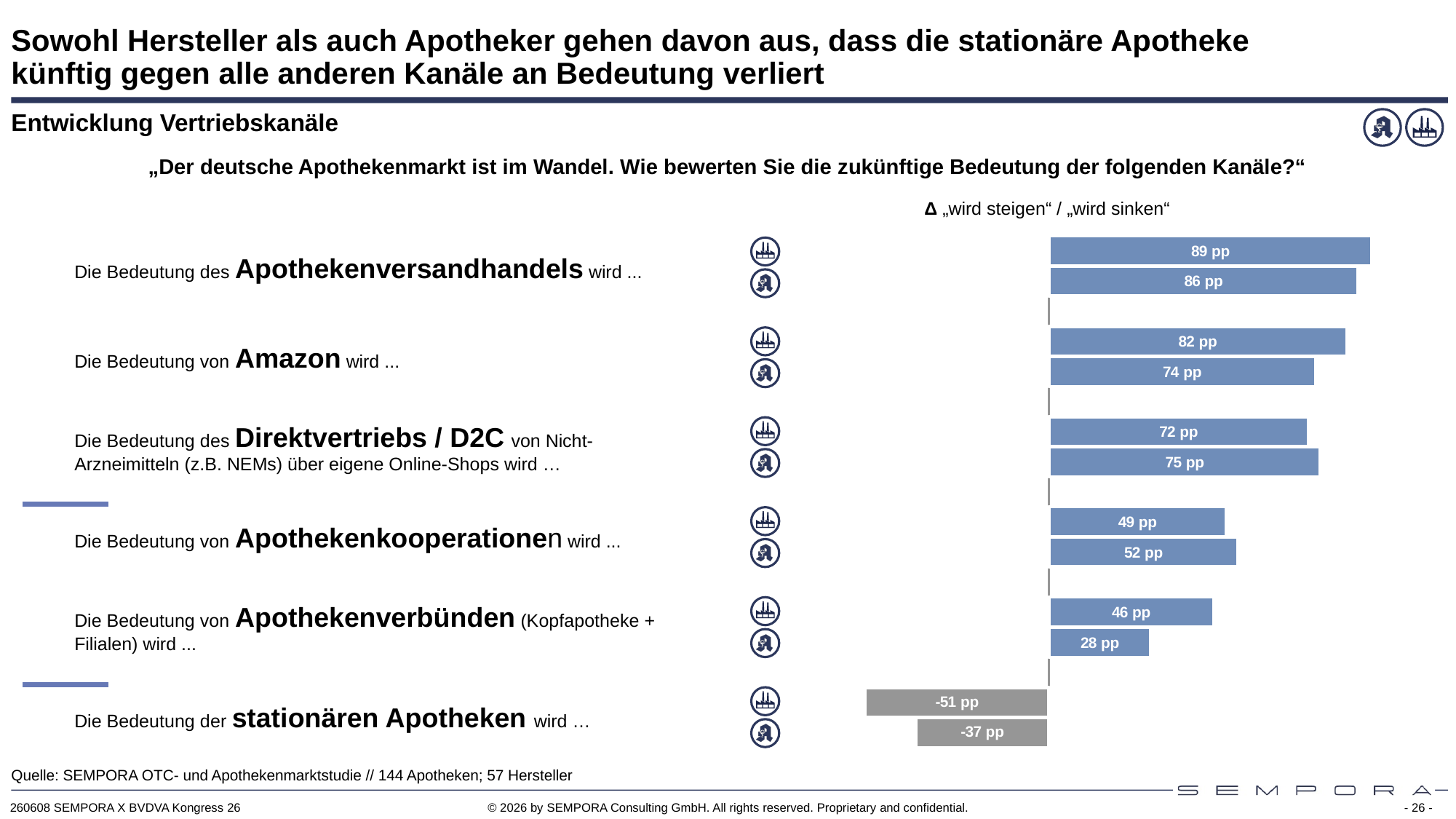
Which channel has the lowest value in the chart? stationären Apotheken What is the value of the upper bar for stationären Apotheken? -51 pp How many channels (categories) are shown in the chart? 6 What is the value of the lower bar for Apothekenverbünden? 28 pp What is the value of the upper bar for Apothekenversandhandel? 89 pp Which channel has the highest value in the chart? Apothekenversandhandel Which channel is the only one with negative values in the chart? stationären Apotheken What kind of chart is shown on the slide? bar chart What is the difference between the upper and lower bars for Apothekenverbünden? 18 pp What is the difference between the two bars for Amazon? 8 pp For Direktvertriebs / D2C, which bar is larger, the upper or the lower one? the lower one (75 pp) What is the value of the lower bar for Amazon? 74 pp